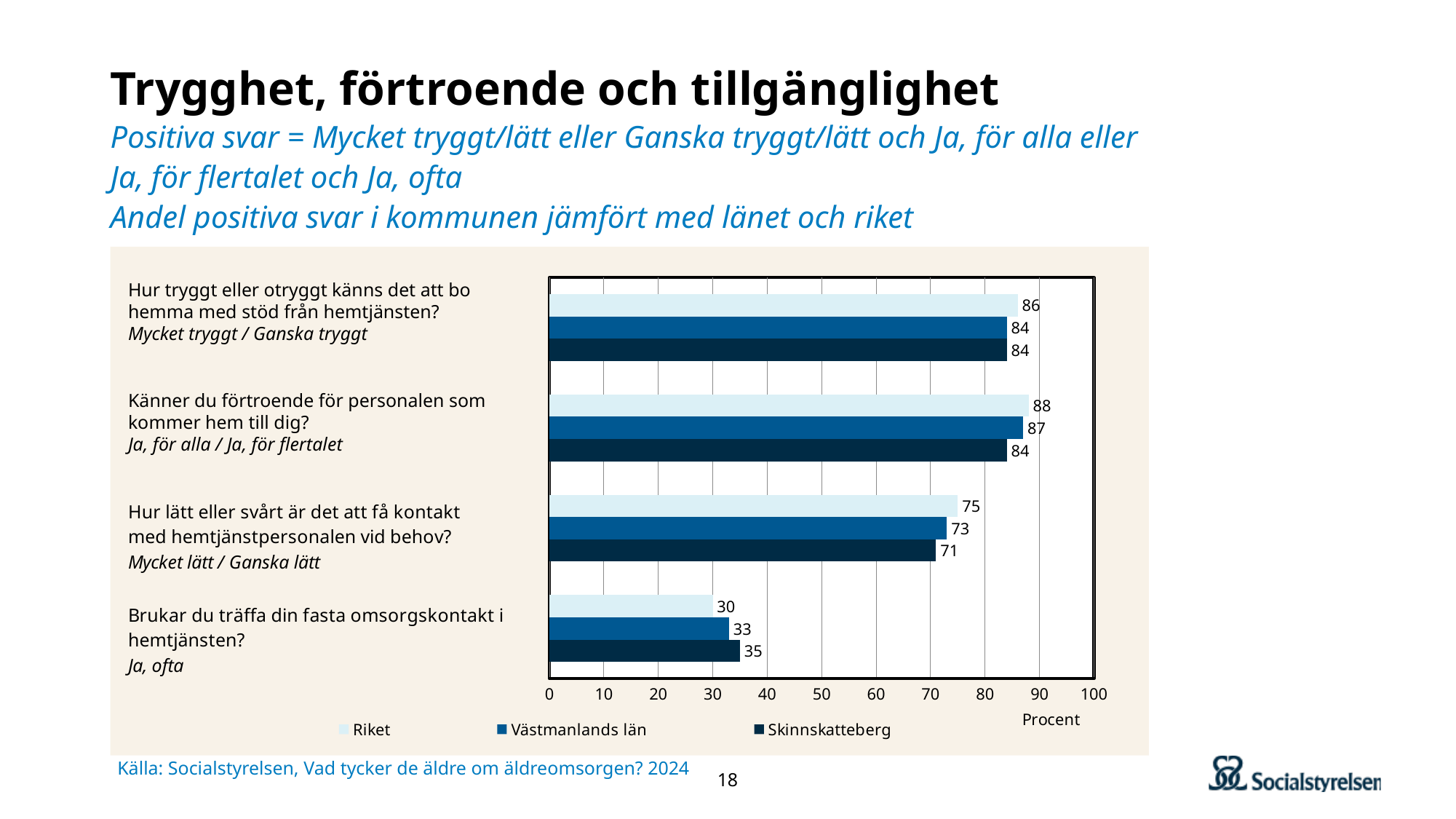
How many questions (categories) are shown in the chart? 4 What is the value for Skinnskatteberg on "Brukar du träffa din fasta omsorgskontakt i hemtjänsten?"? 35 What is the difference between Riket and Skinnskatteberg on "Känner du förtroende för personalen som kommer hem till dig?"? 4 On "Brukar du träffa din fasta omsorgskontakt i hemtjänsten?", which is larger: Riket or Skinnskatteberg? Skinnskatteberg Which question has the lowest value for Riket? Brukar du träffa din fasta omsorgskontakt i hemtjänsten? Is the value for Riket on "Hur lätt eller svårt är det att få kontakt med hemtjänstpersonalen vid behov?" greater or less than 70? greater Which question has the highest value for Skinnskatteberg? Hur tryggt eller otryggt känns det att bo hemma med stöd från hemtjänsten? / Känner du förtroende för personalen som kommer hem till dig? (both 84) What is the value for Riket on "Känner du förtroende för personalen som kommer hem till dig?"? 88 What kind of chart is shown on the slide? Bar chart How many series does the legend list? 3 What is the value for Västmanlands län on "Hur lätt eller svårt är det att få kontakt med hemtjänstpersonalen vid behov?"? 73 What unit is shown on the x axis of the chart? Procent